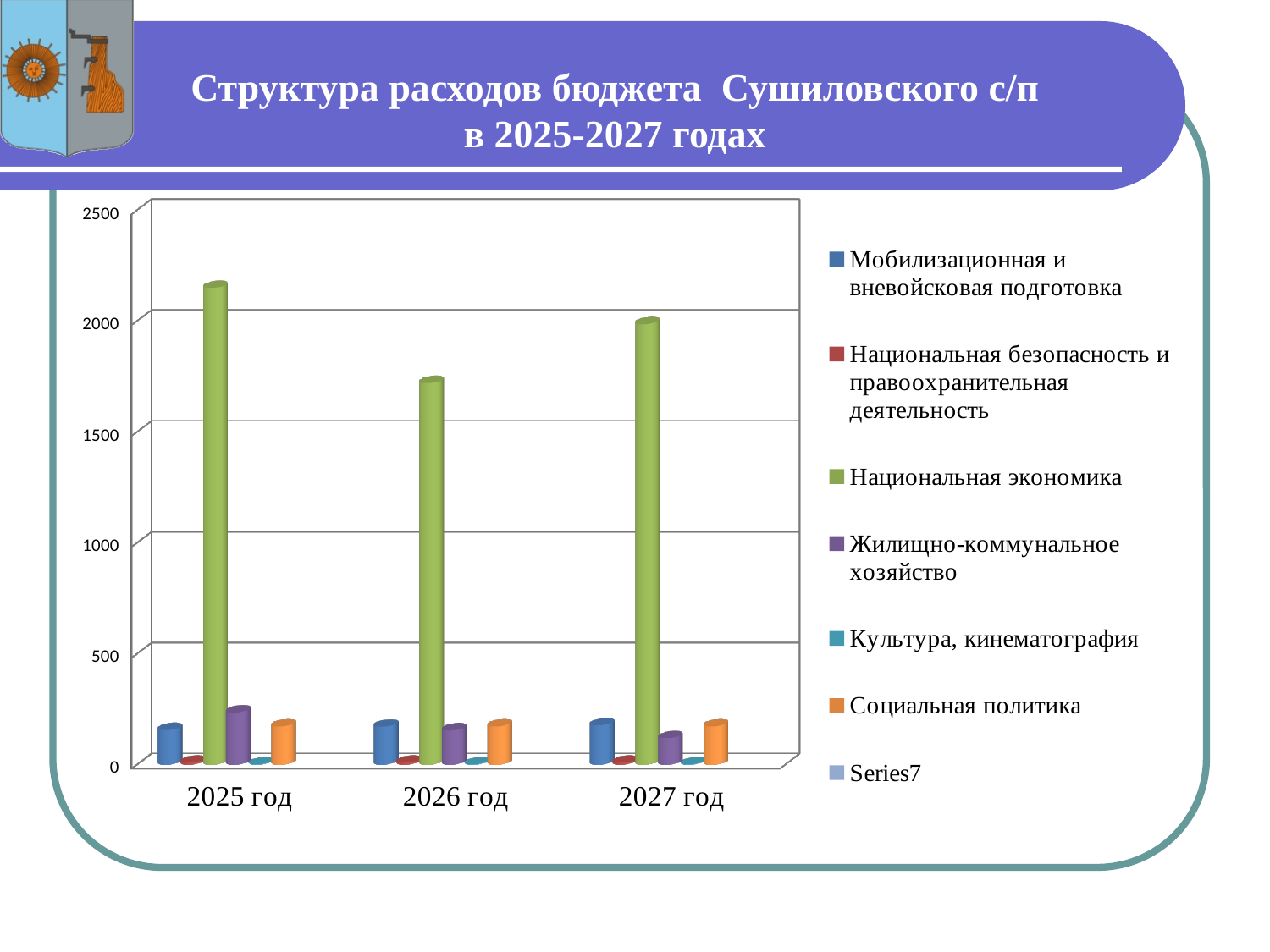
Which series has the highest value in 2025 год? Национальная экономика How many year categories are shown on the x axis? 3 What colour are the bars for Национальная экономика? green Which is larger for Жилищно-коммунальное хозяйство: the value in 2025 год or in 2027 год? 2025 год How many series does the legend list? 7 In which year is the value for Национальная экономика the highest? 2025 год Is the value for Жилищно-коммунальное хозяйство in 2025 год greater or less than 500? less In which year is the value for Национальная экономика the lowest? 2026 год What kind of chart is shown on the slide? bar chart Is the value for Национальная экономика in 2025 год greater or less than 2000? greater Is the value for Национальная экономика in 2026 год greater or less than 2000? less